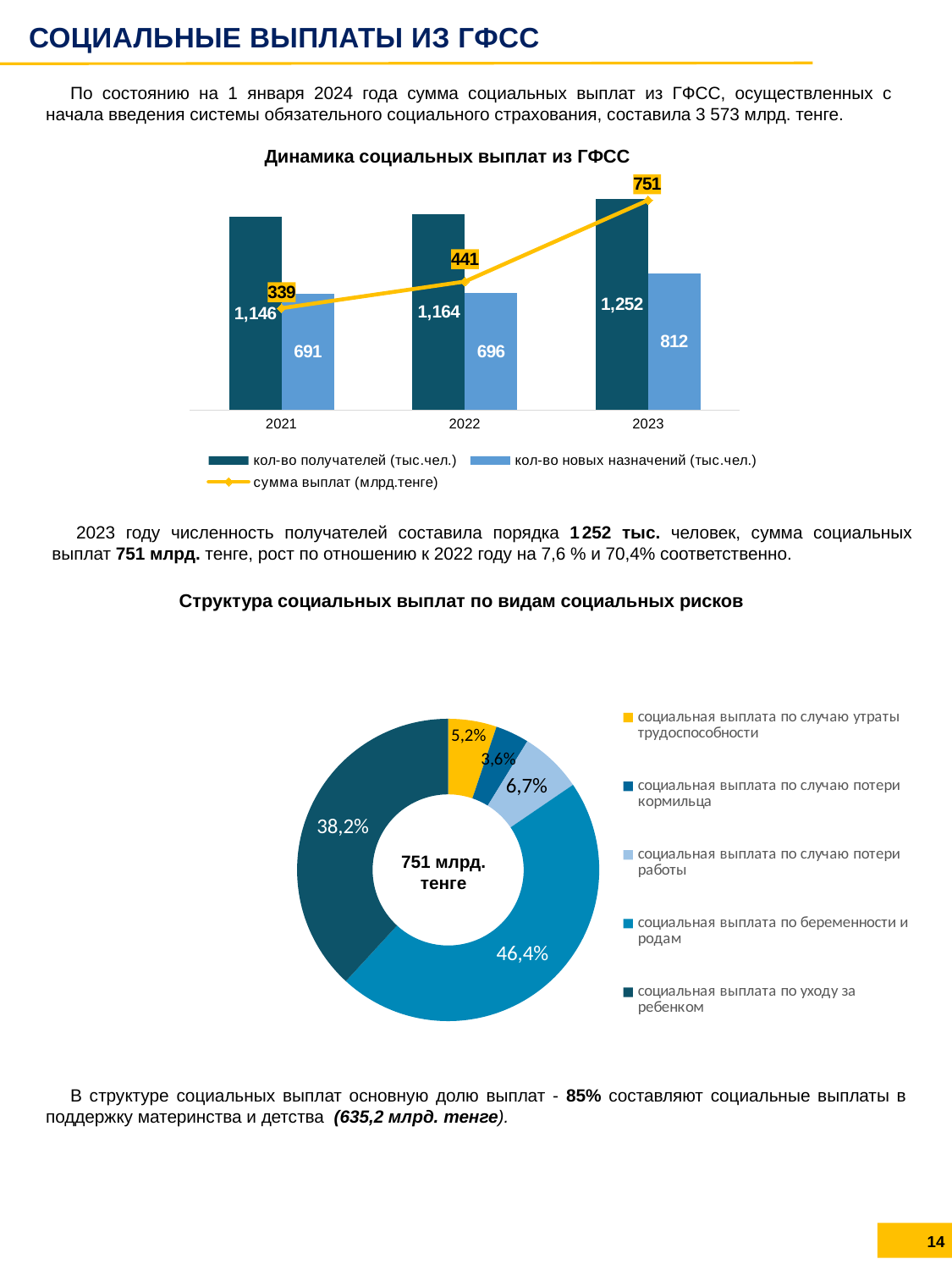
In the chart 'Динамика социальных выплат из ГФСС', what is the value of 'сумма выплат (млрд.тенге)' for 2021? 339 How many years are shown on the x axis of the chart 'Динамика социальных выплат из ГФСС'? 3 In the chart 'Структура социальных выплат по видам социальных рисков', which category has the smallest share? социальная выплата по случаю потери кормильца In the chart 'Динамика социальных выплат из ГФСС', which year has the highest value of 'кол-во новых назначений (тыс.чел.)'? 2023 In the chart 'Динамика социальных выплат из ГФСС', what is the value of 'кол-во получателей (тыс.чел.)' for 2023? 1,252 In the chart 'Структура социальных выплат по видам социальных рисков', what share is 'социальная выплата по беременности и родам'? 46,4% What value is printed in the centre of the chart 'Структура социальных выплат по видам социальных рисков'? 751 млрд. тенге In the chart 'Динамика социальных выплат из ГФСС', does 'сумма выплат (млрд.тенге)' rise or fall from 2021 to 2023? rise In the chart 'Динамика социальных выплат из ГФСС', by how much did 'сумма выплат (млрд.тенге)' increase from 2022 to 2023? 310 In the chart 'Динамика социальных выплат из ГФСС', what is the value of 'кол-во новых назначений (тыс.чел.)' for 2022? 696 What kind of chart is 'Структура социальных выплат по видам социальных рисков'? doughnut (pie) chart How many series does the legend of the chart 'Динамика социальных выплат из ГФСС' list? 3